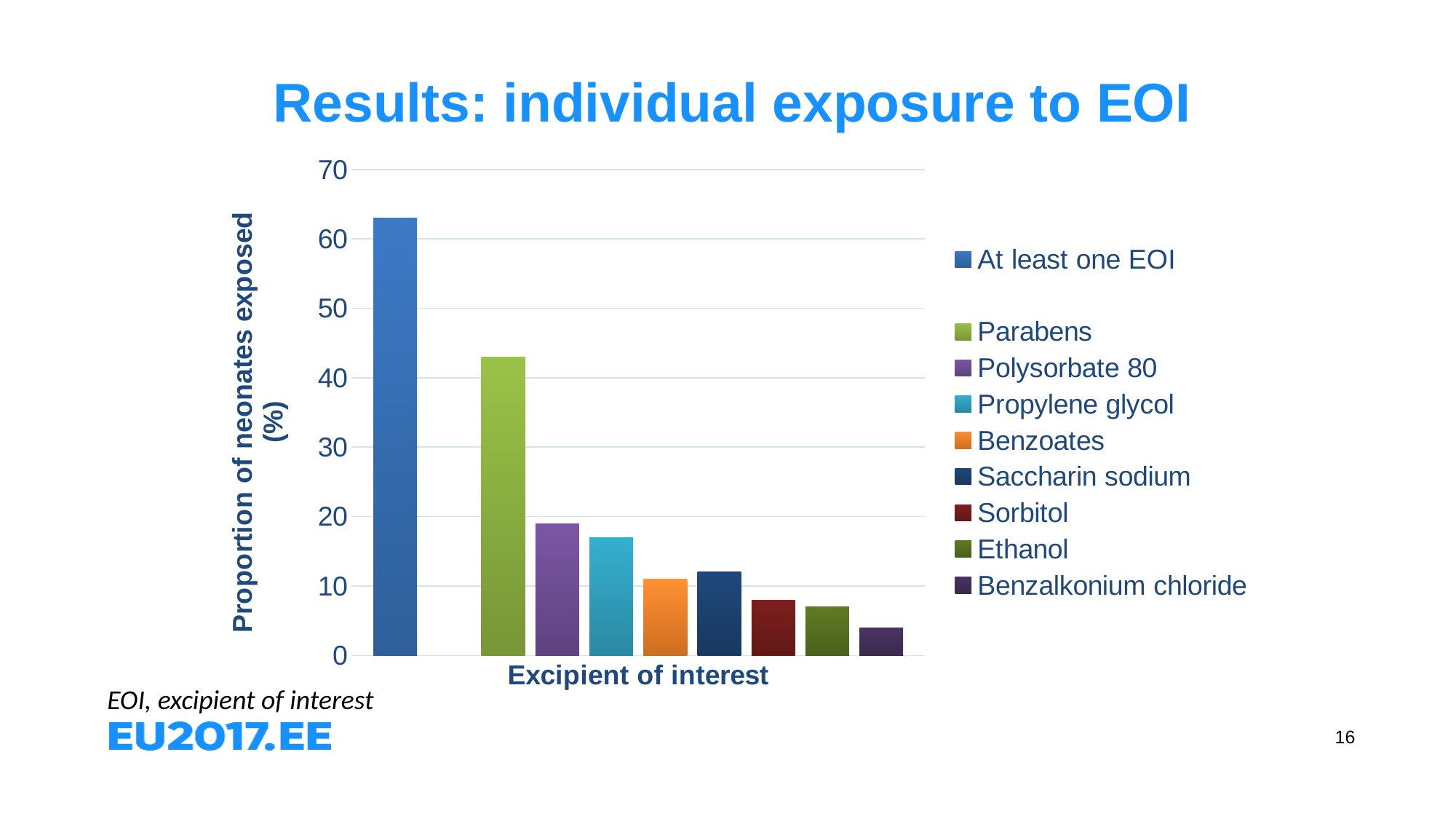
Which is larger, the value for Parabens or the value for Polysorbate 80? Parabens Is the value for Benzalkonium chloride greater or less than 10? less How many bars are plotted in the chart? 9 How many series does the legend list? 9 What kind of chart is shown on the slide? bar chart Is the value for Polysorbate 80 greater or less than 20? less Which is larger, the value for Propylene glycol or the value for Sorbitol? Propylene glycol Is the value for Parabens greater or less than 40? greater Which category has the highest proportion of neonates exposed? At least one EOI What is the label of the y axis? Proportion of neonates exposed (%) Which category has the lowest proportion of neonates exposed? Benzalkonium chloride